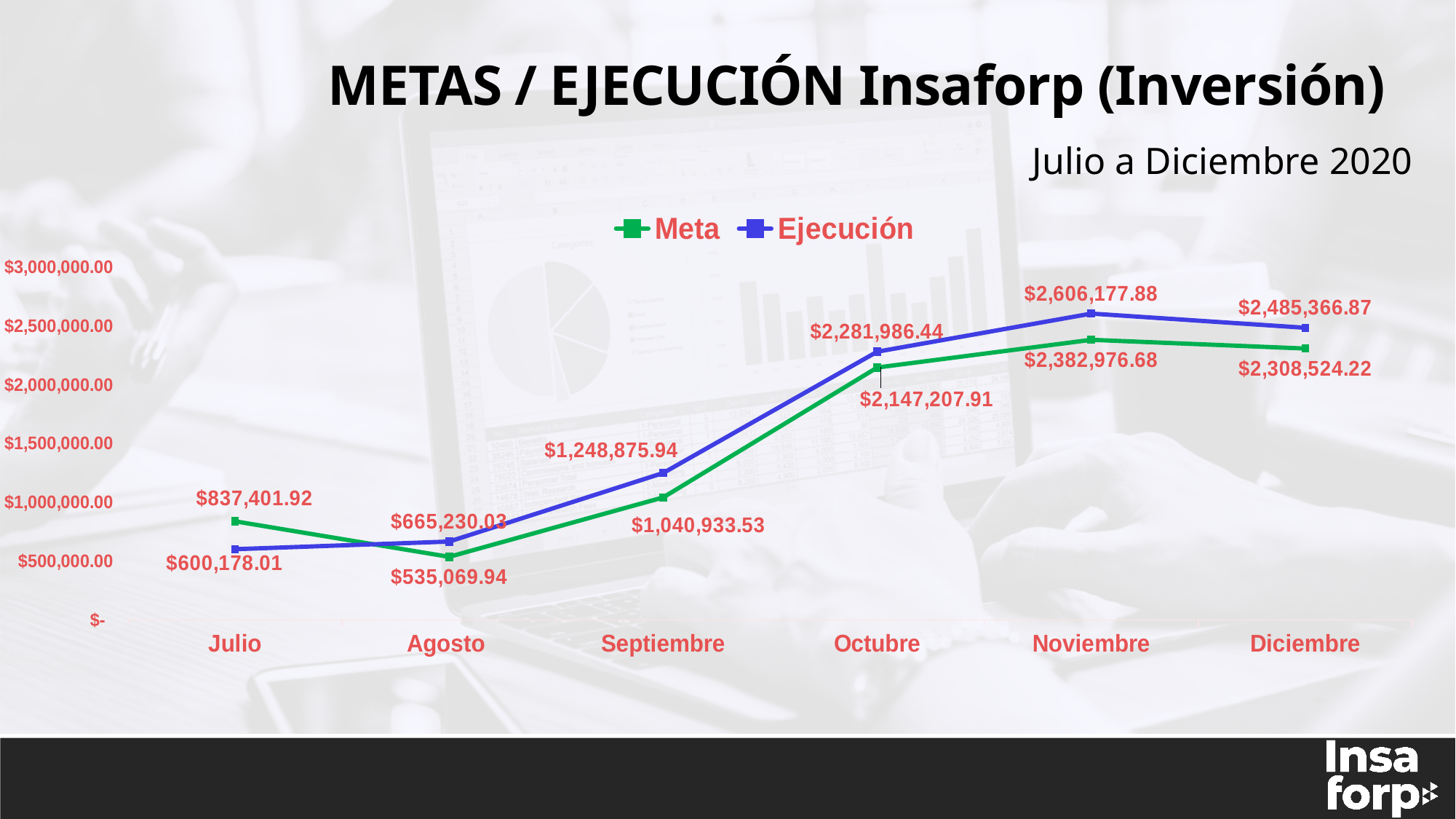
In Julio, which is larger, the Meta value or the Ejecución value? Meta What is the difference between the Ejecución and Meta values in Noviembre? $223,201.20 In which month is the Ejecución value highest? Noviembre What is the Meta value for Julio? $837,401.92 How many series does the legend list? 2 What is the Ejecución value for Agosto? $665,230.03 Is the Ejecución value for Septiembre greater or less than $1,000,000.00? greater How many months are shown on the x axis? 6 In which month is the Meta value lowest? Agosto What is the Ejecución value for Octubre? $2,281,986.44 What is the Meta value for Diciembre? $2,308,524.22 What kind of chart is shown on the slide? line chart